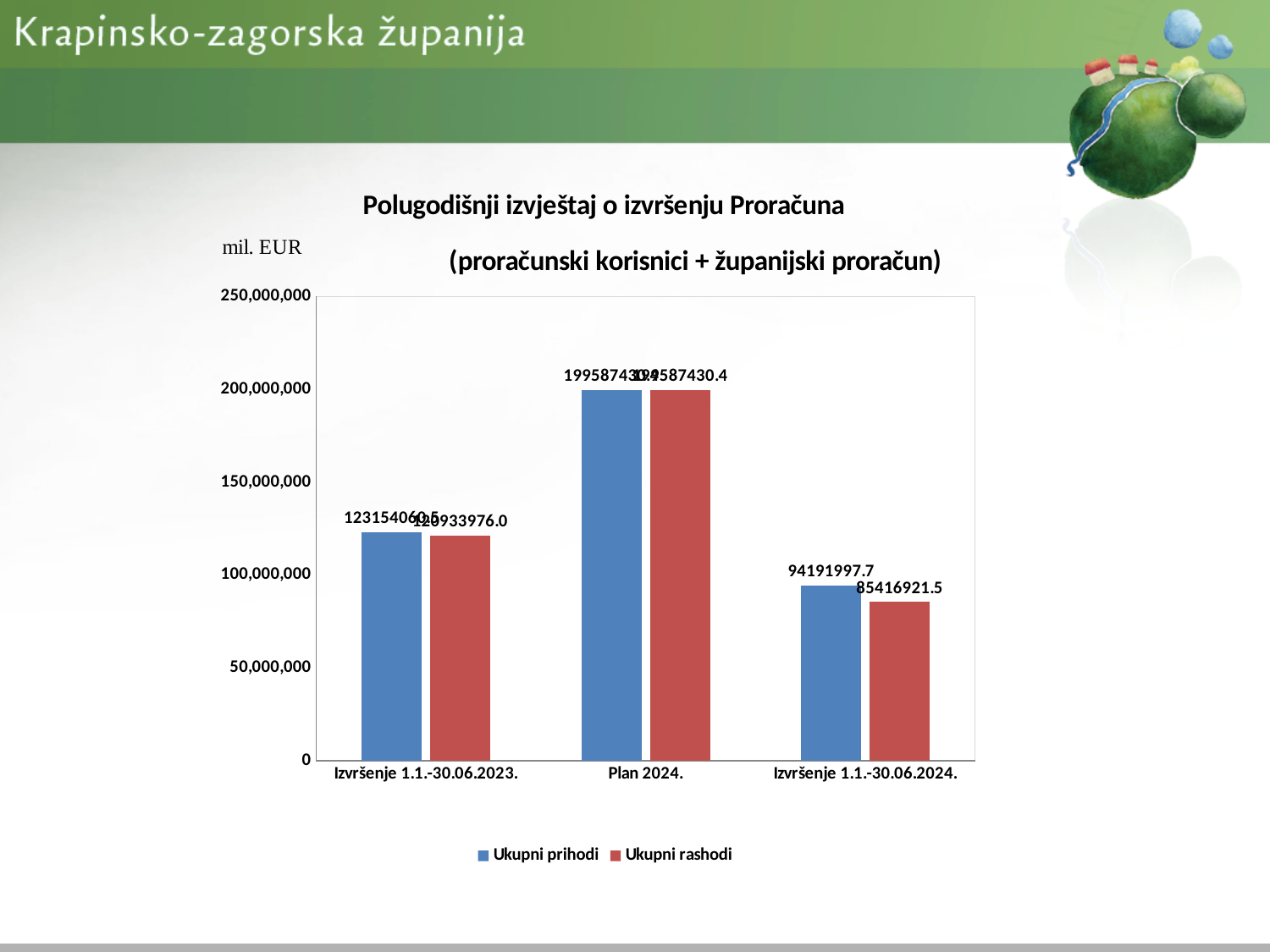
What type of chart is shown on the slide? bar chart What is the value of Ukupni prihodi for Izvršenje 1.1.-30.06.2024.? 94191997.7 Is the value of Ukupni rashodi for Izvršenje 1.1.-30.06.2023. greater or less than 150,000,000? less Is the value of Ukupni prihodi for Izvršenje 1.1.-30.06.2023. greater or less than 100,000,000? greater For Izvršenje 1.1.-30.06.2024., which is larger: Ukupni prihodi or Ukupni rashodi? Ukupni prihodi How many series does the legend list? 2 How many categories are shown on the x axis? 3 What is the value of Ukupni rashodi for Plan 2024.? 199587430.4 What is the difference between Ukupni prihodi and Ukupni rashodi for Izvršenje 1.1.-30.06.2024.? 8775076.2 Which category has the lowest Ukupni rashodi? Izvršenje 1.1.-30.06.2024. What is the value of Ukupni rashodi for Izvršenje 1.1.-30.06.2024.? 85416921.5 Which category has the highest Ukupni prihodi? Plan 2024.